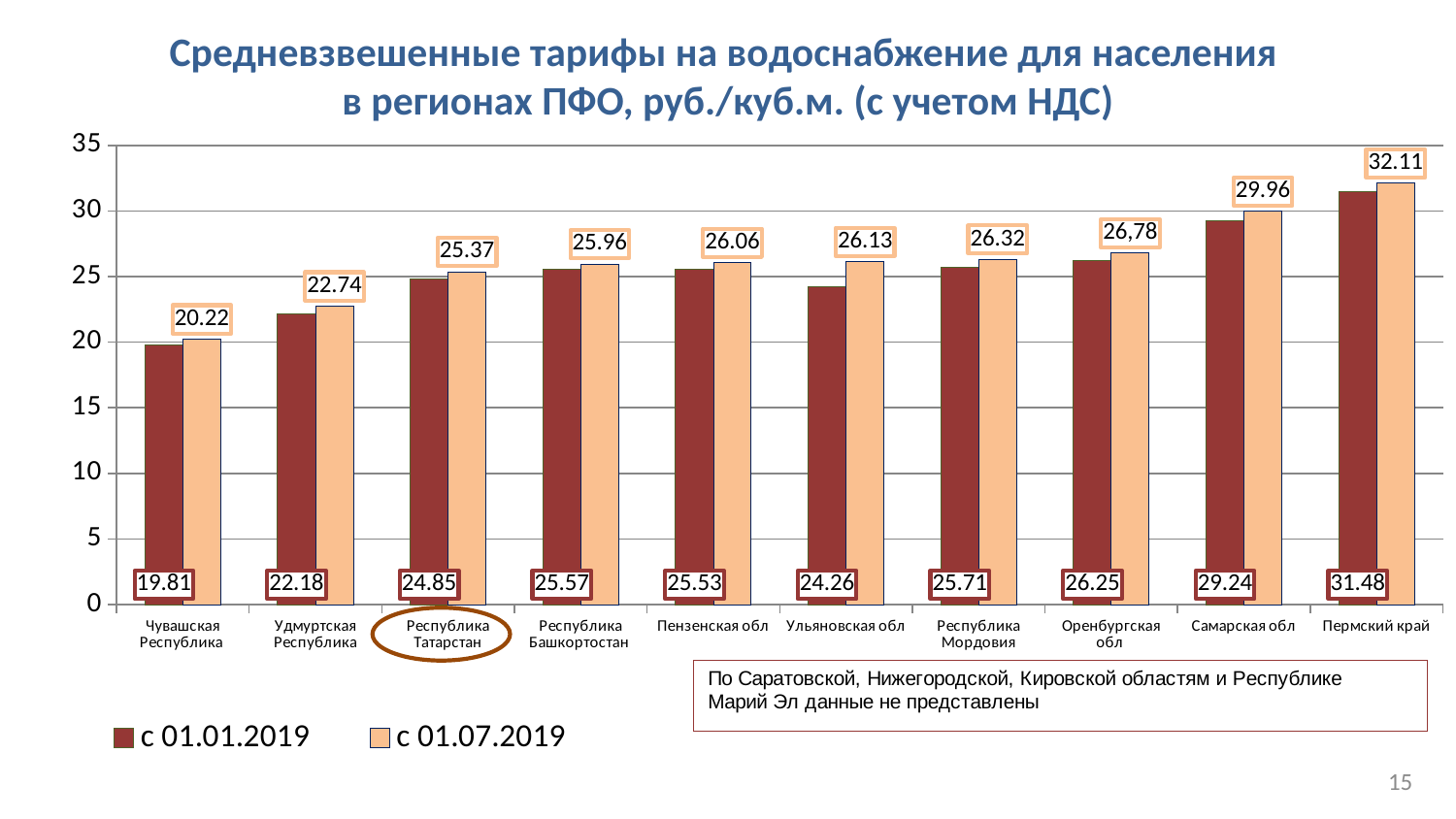
How many series does the legend list? 2 What kind of chart is shown on the slide? bar chart Which region's label is circled on the x axis? Республика Татарстан Which is larger: the с 01.01.2019 value for Республика Мордовия or the с 01.01.2019 value for Пензенская обл? Республика Мордовия Which region has the lowest value in the series с 01.01.2019? Чувашская Республика How many regions are shown on the x axis of the chart? 10 Is the с 01.07.2019 value for Удмуртская Республика greater or less than 25? less What is the difference between the с 01.07.2019 and с 01.01.2019 values for Ульяновская обл? 1.87 Which region has the highest value in the series с 01.07.2019? Пермский край What is the value for Самарская обл in the series с 01.01.2019? 29.24 What is the value for Республика Татарстан in the series с 01.07.2019? 25.37 What is the value for Оренбургская обл in the series с 01.07.2019? 26,78